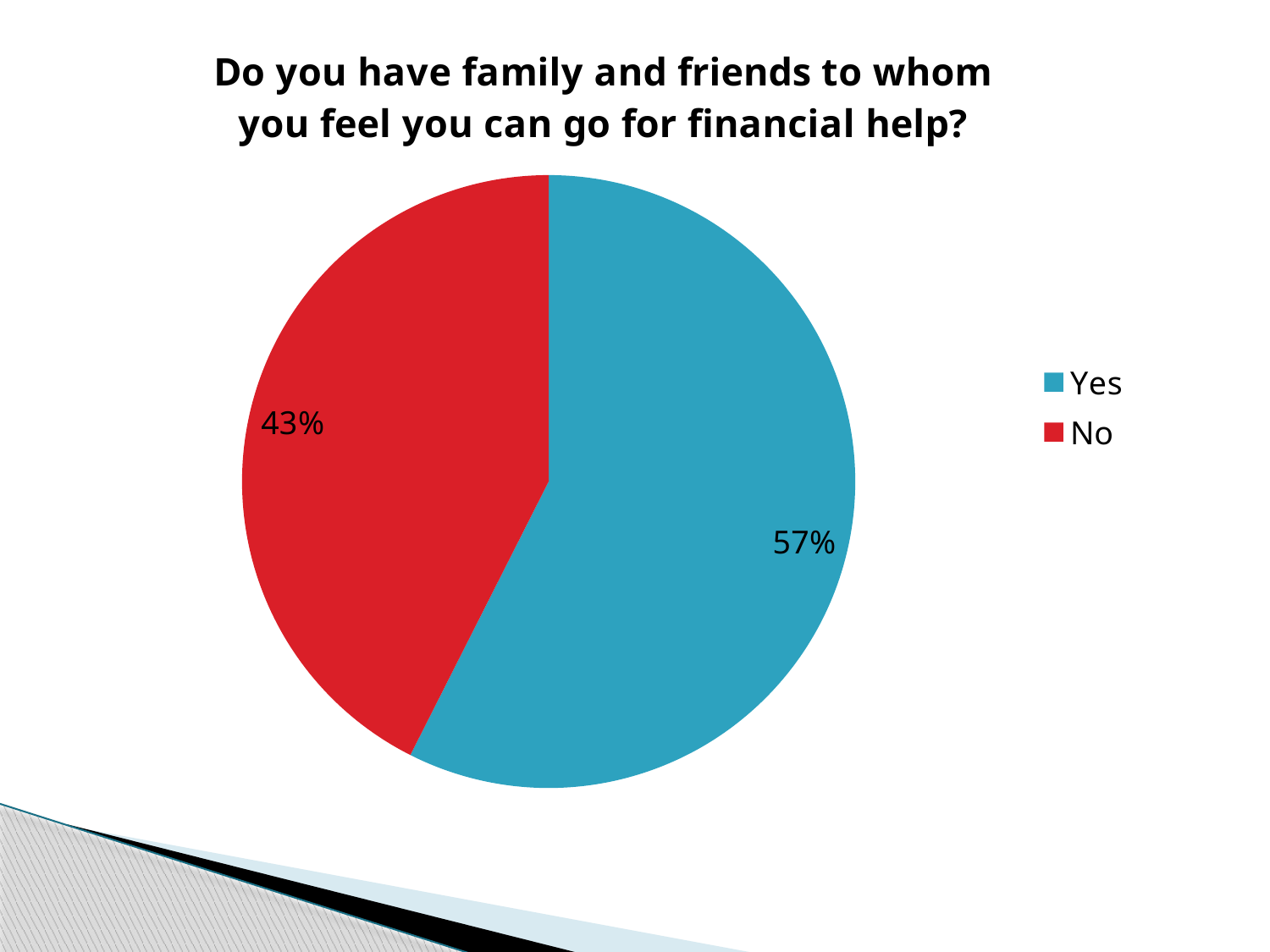
What percentage of respondents answered Yes? 57% What share of the pie does the No slice represent? 43% What colour is the Yes slice? blue How many slices does the pie chart have? 2 What is the difference in percentage points between the Yes and No shares? 14 Which is larger, the share for Yes or the share for No? Yes What percentage of respondents answered No? 43% What kind of chart is shown on the slide? pie chart Which response has the largest share of the pie? Yes Which response has the smallest share of the pie? No How many entries does the legend list? 2 What is the title of the chart? Do you have family and friends to whom you feel you can go for financial help?